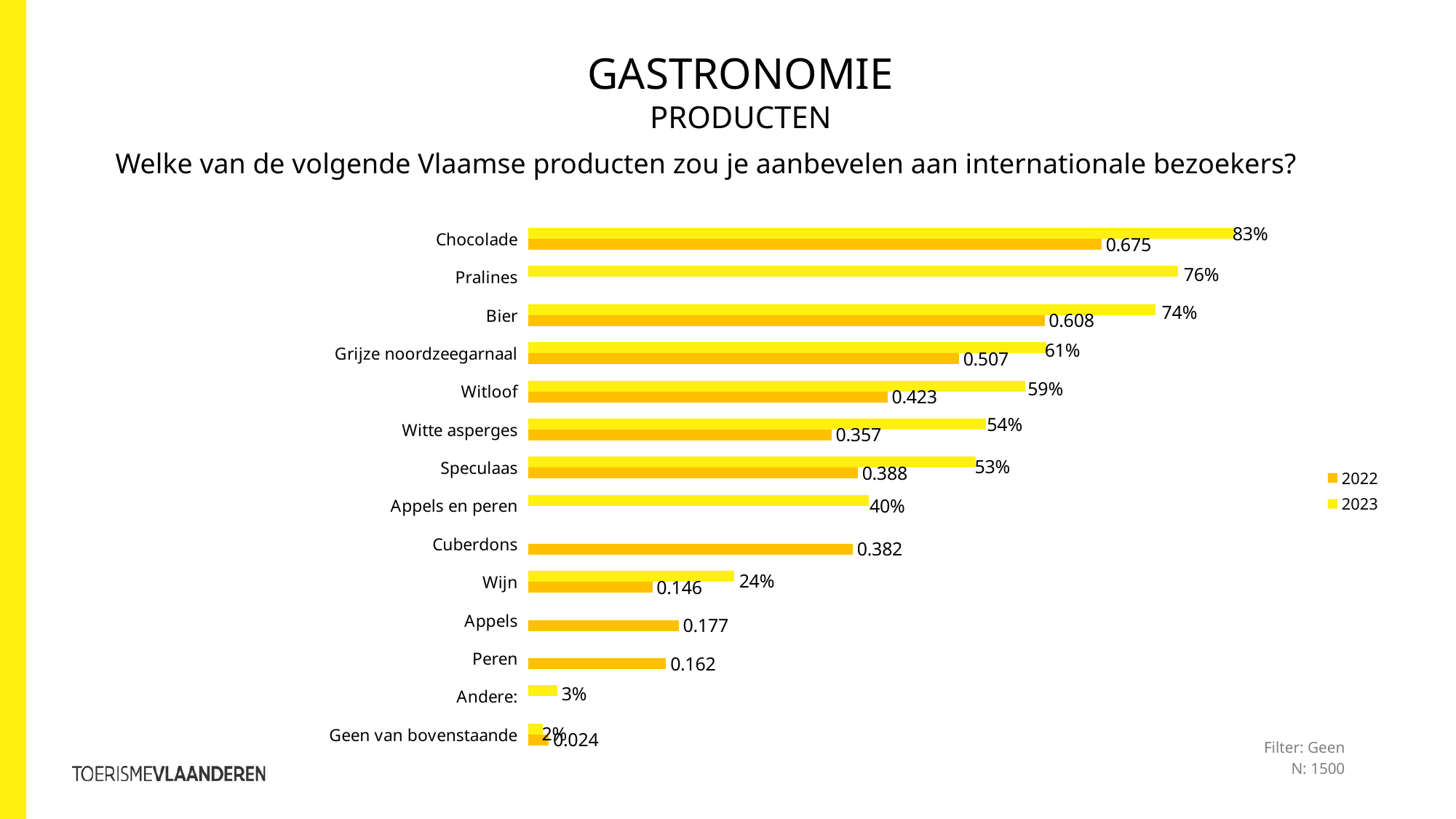
What is the 2022 value for Bier? 0.608 Which category has the highest 2023 value? Chocolade What is the 2023 value for Chocolade? 83% What is the 2022 value for Cuberdons? 0.382 What is the difference between the 2023 values for Pralines and Bier? 2% How many series does the legend list? 2 Which category has the lowest 2022 value? Geen van bovenstaande What is the 2023 value for Appels en peren? 40% What kind of chart is shown on the slide? Bar chart Which series is shown in the lighter yellow colour? 2023 How many categories are shown on the chart? 14 Which is larger, the 2022 value for Speculaas or the 2022 value for Witte asperges? Speculaas